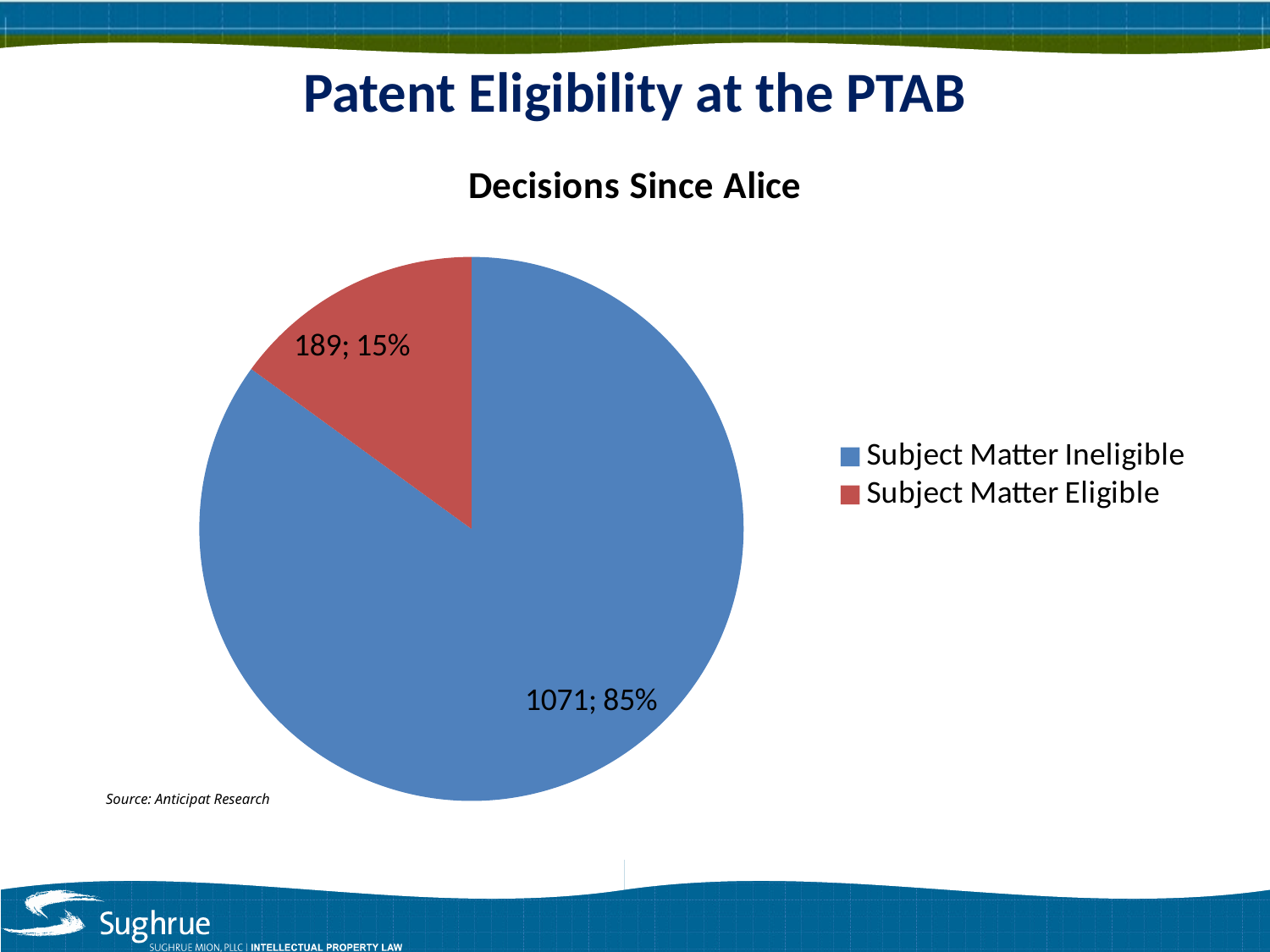
What share of the pie is Subject Matter Ineligible? 85% Which category has the smallest slice? Subject Matter Eligible What is the total number of decisions shown in the pie chart? 1260 How many entries does the legend list? 2 How many slices does the pie chart have? 2 How many more decisions were Subject Matter Ineligible than Subject Matter Eligible? 882 What share of the pie is Subject Matter Eligible? 15% What is the title of the chart? Decisions Since Alice How many decisions were Subject Matter Ineligible? 1071 Which category has the largest slice? Subject Matter Ineligible How many decisions were Subject Matter Eligible? 189 What kind of chart is shown on the slide? pie chart